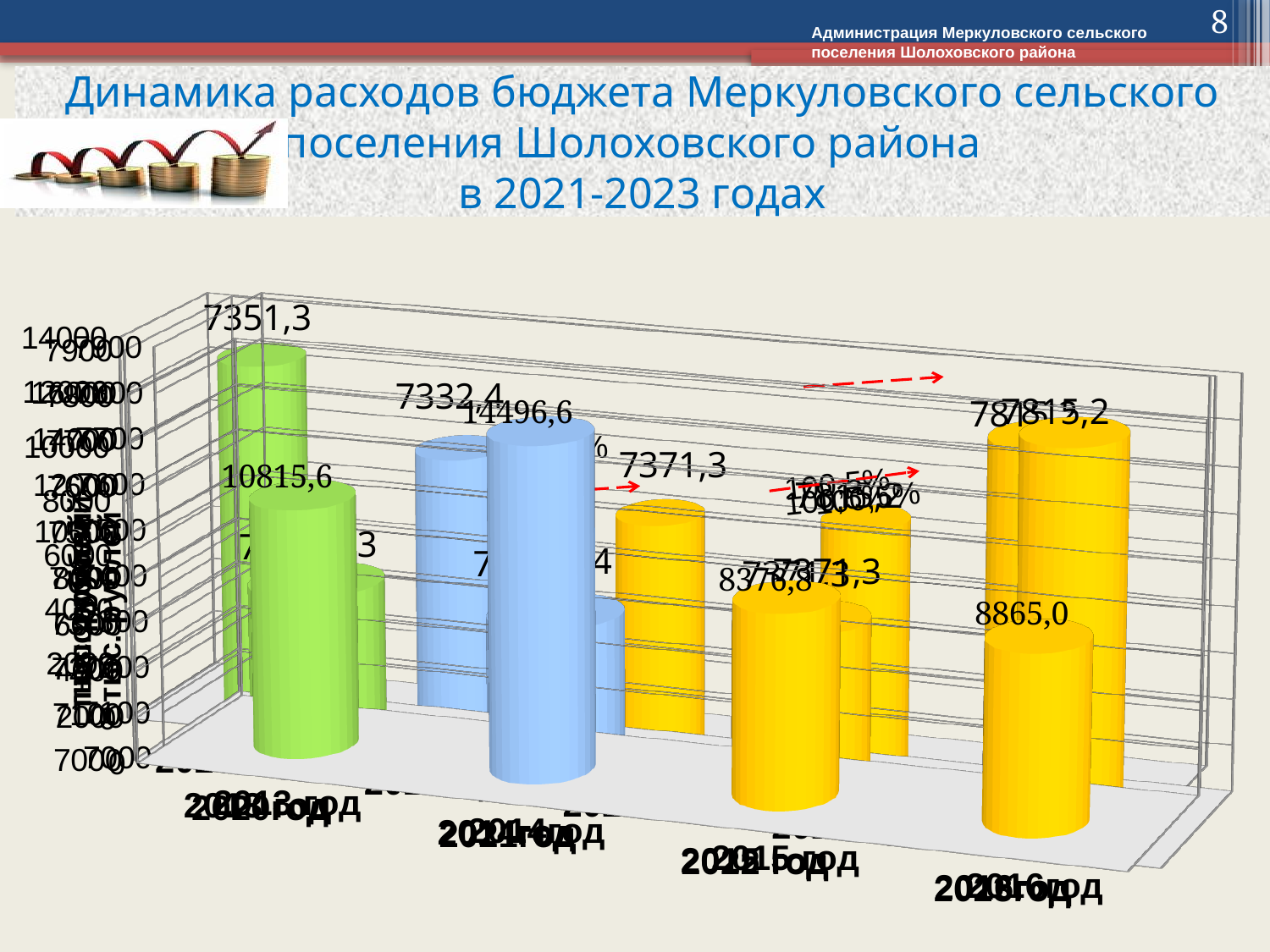
Which years does the chart title say the data covers? 2021-2023 What is the largest data label printed on the chart? 14496,6 What kind of chart is shown on the slide? bar chart What is the title of the chart on the slide? Динамика расходов бюджета Меркуловского сельского поселения Шолоховского района в 2021-2023 годах